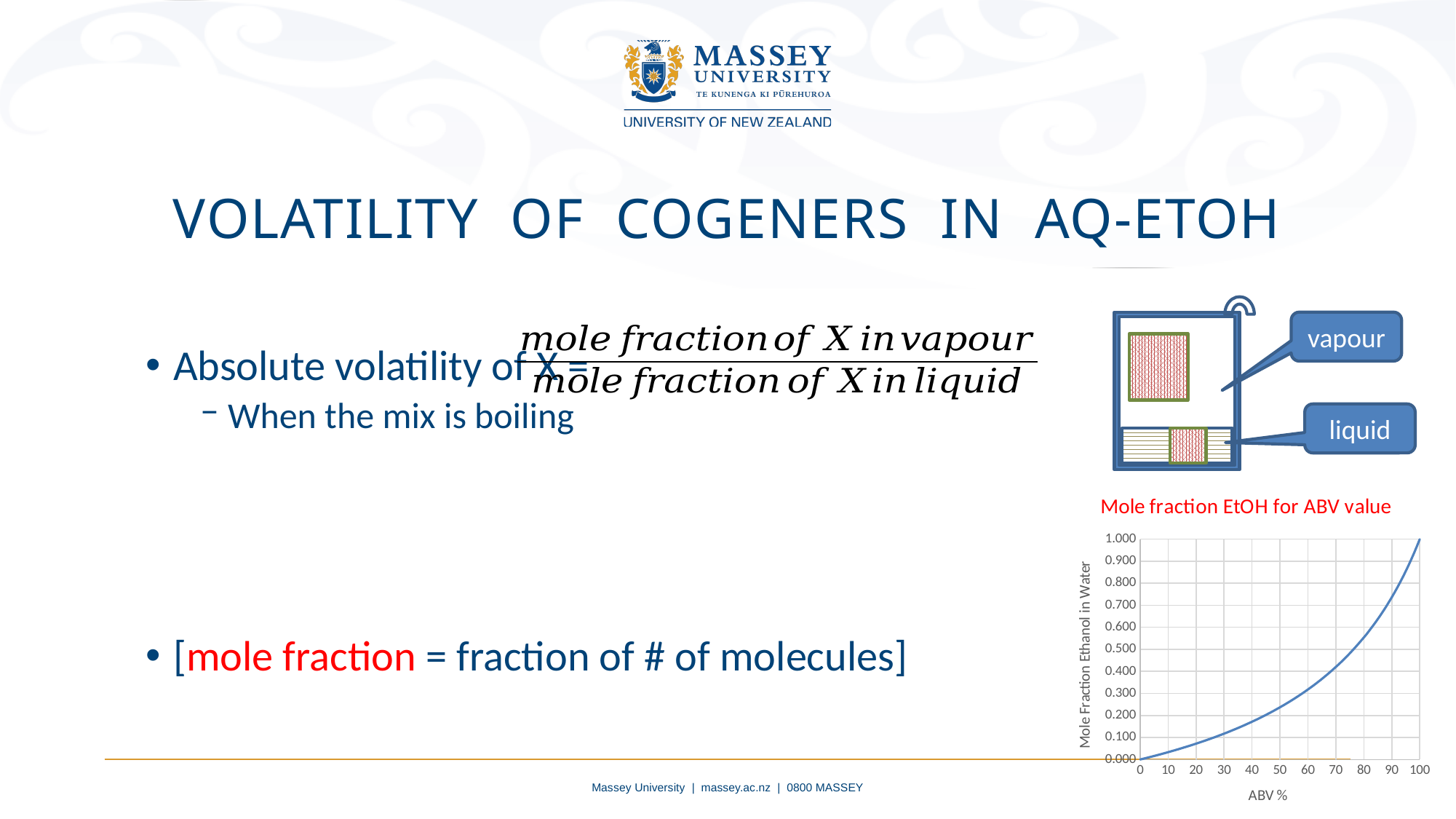
Does the mole fraction of ethanol rise or fall as ABV % increases along the x axis? rise At which ABV % value is the mole fraction of ethanol highest? 100 What is the mole fraction of ethanol at 100 ABV %? 1.000 Is the mole fraction of ethanol at 80 ABV % greater or less than 0.400? greater What is the label of the y axis of the chart? Mole Fraction Ethanol in Water Is the mole fraction of ethanol at 20 ABV % greater or less than 0.200? less Is the mole fraction of ethanol at 90 ABV % greater or less than 0.600? greater What kind of chart is shown on the slide? line chart Which is larger, the mole fraction of ethanol at 40 ABV % or at 70 ABV %? 70 ABV % What is the mole fraction of ethanol at 0 ABV %? 0.000 What is the title of the chart on the slide? Mole fraction EtOH for ABV value